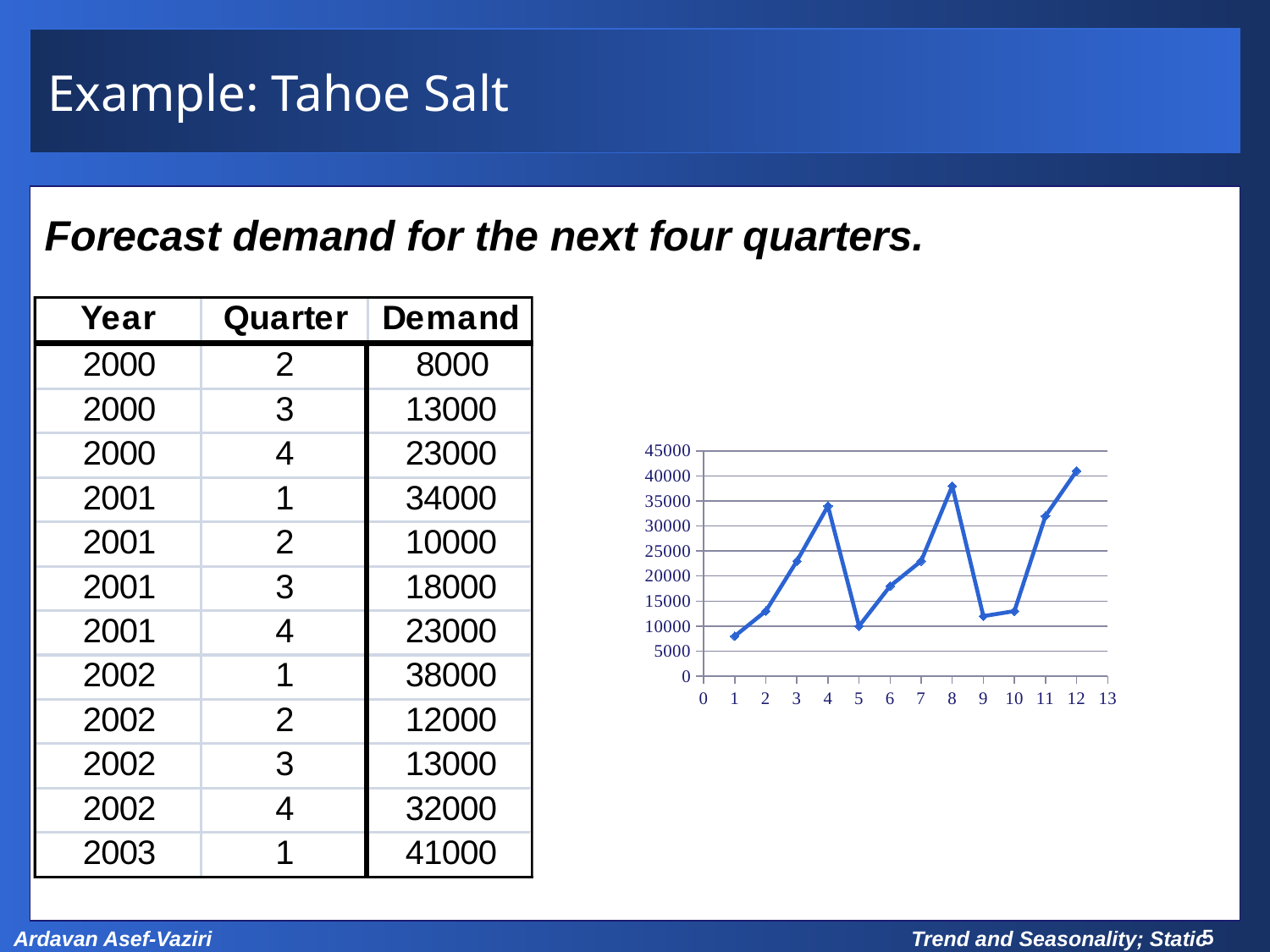
Is the value at x = 8 on the line chart greater or less than 35000? greater What kind of chart is shown on the slide? line chart Does the line rise or fall from x = 1 to x = 4? rise Which is larger on the line chart, the value at x = 4 or the value at x = 8? x = 8 How many data points are plotted on the line chart? 12 Is the value at x = 3 on the line chart greater or less than 25000? less What is the demand value plotted at x = 5 on the line chart? 10000 At which x-axis position does the line chart reach its highest value? 12 Is the value at x = 11 on the line chart greater or less than 30000? greater What is the highest value shown on the y axis of the line chart? 45000 At which x-axis position does the line chart reach its lowest value? 1